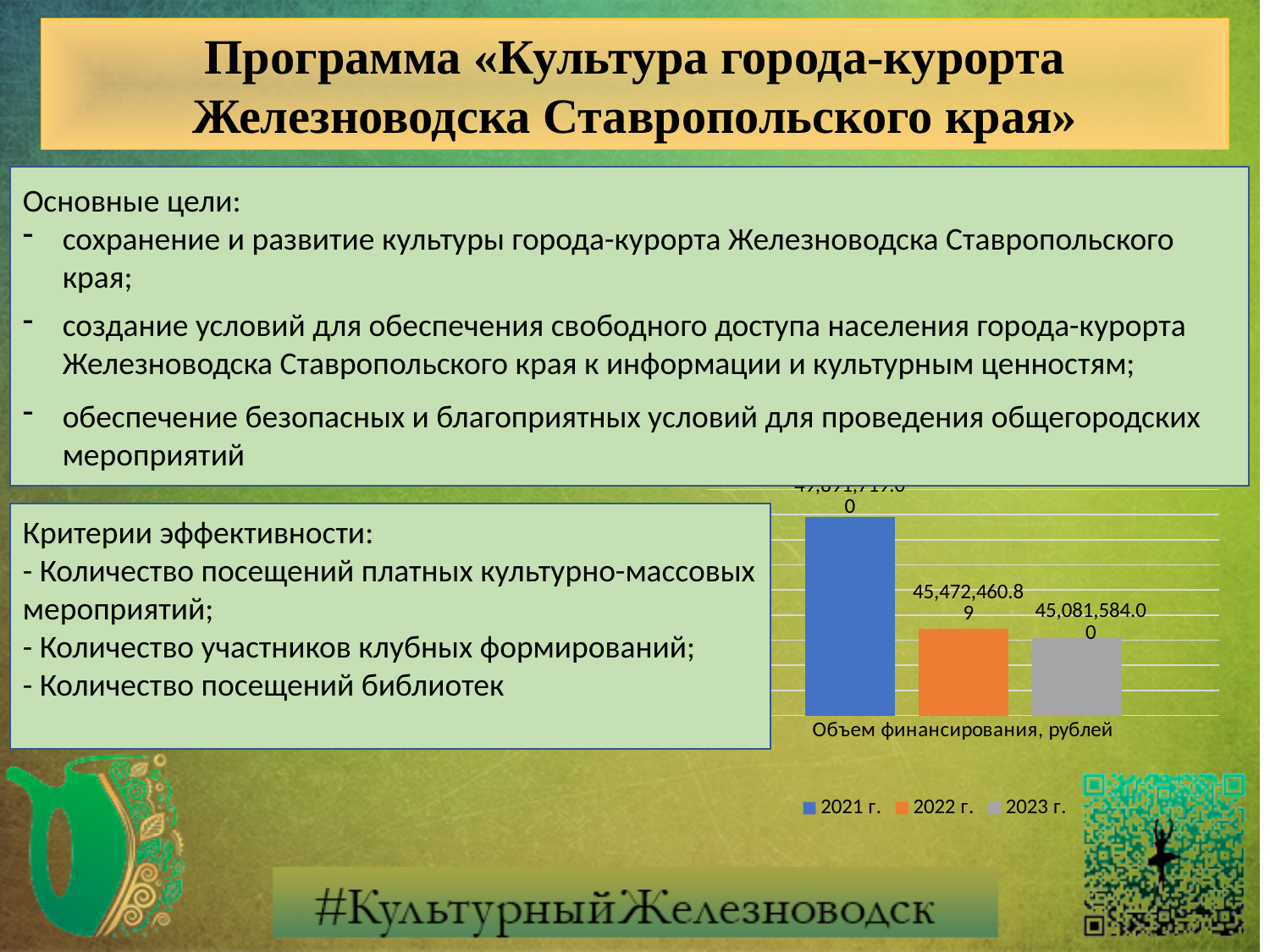
Which is larger in the chart, the value for 2022 г. or for 2023 г.? 2022 г. Do the values in the chart rise or fall from 2021 г. to 2023 г.? fall What is the difference between the values for 2022 г. and 2023 г. in the chart? 390,876.89 Which year has the lowest value in the chart? 2023 г. What colour is the bar for 2022 г. in the chart? orange What is the category label shown under the bars in the chart? Объем финансирования, рублей What type of chart is shown on the slide? bar chart What is the value for 2023 г. in the chart? 45,081,584.00 Which year has the highest value in the chart? 2021 г. How many bars are plotted in the chart? 3 How many series does the chart legend list? 3 What is the value for 2022 г. in the chart? 45,472,460.89